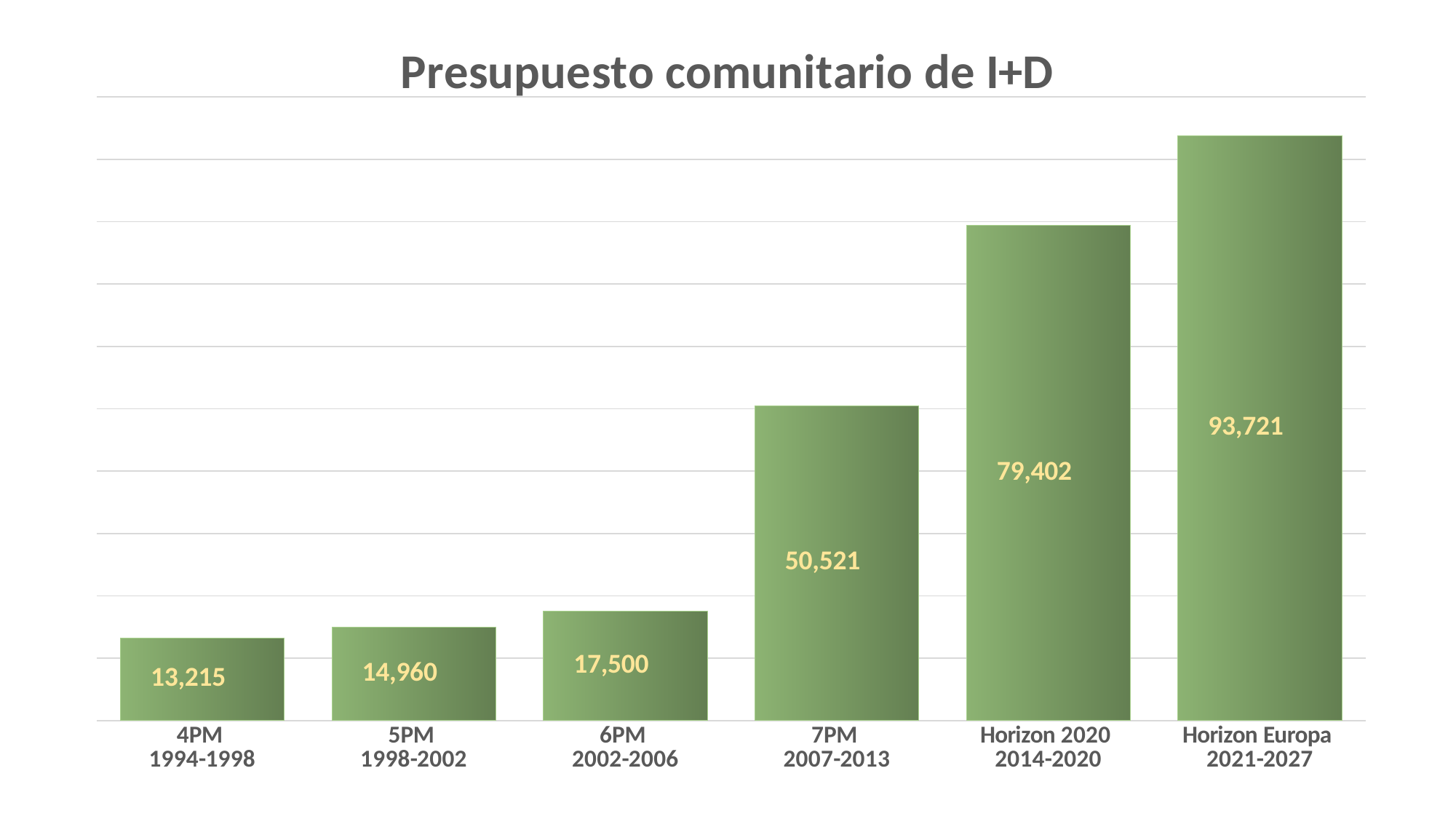
Which is larger, the value for 7PM (2007-2013) or the value for 6PM (2002-2006)? 7PM 2007-2013 How many categories are shown on the x axis? 6 Do the values rise or fall from left to right along the x axis? Rise What is the value for 4PM (1994-1998)? 13,215 What is the difference between the values for 6PM (2002-2006) and 5PM (1998-2002)? 2,540 Which category has the highest value? Horizon Europa 2021-2027 What is the value for 7PM (2007-2013)? 50,521 What is the value for Horizon 2020 (2014-2020)? 79,402 What is the difference between the values for Horizon Europa (2021-2027) and Horizon 2020 (2014-2020)? 14,319 What kind of chart is shown on the slide? Bar chart Which category has the lowest value? 4PM 1994-1998 What is the title of the chart? Presupuesto comunitario de I+D